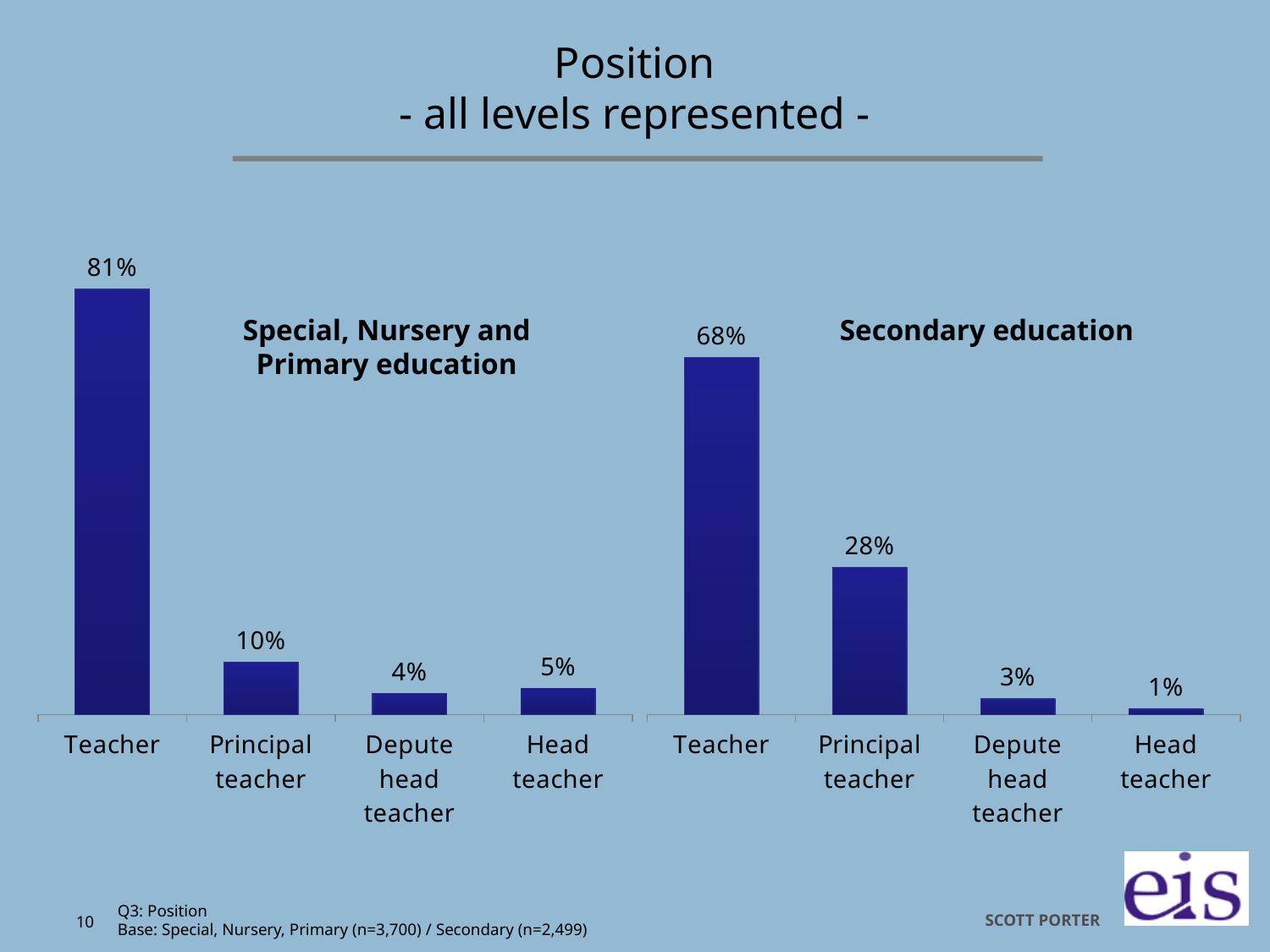
In the Special, Nursery and Primary education chart, what is the value for Depute head teacher? 4% In the Special, Nursery and Primary education chart, which position has the lowest value? Depute head teacher In the Special, Nursery and Primary education chart, what is the difference between the values for Principal teacher and Head teacher? 5% In the Secondary education chart, what is the difference between the values for Teacher and Principal teacher? 40% Which is larger: the Teacher value in the Special, Nursery and Primary education chart or the Teacher value in the Secondary education chart? Special, Nursery and Primary education How many positions are shown in the Secondary education chart? 4 In the Secondary education chart, which position has the highest value? Teacher In the Secondary education chart, what is the value for Principal teacher? 28% What is the title of the slide? Position - all levels represented - In the Special, Nursery and Primary education chart, what is the value for Teacher? 81% What type of chart is the Special, Nursery and Primary education chart? Bar chart In the Secondary education chart, what is the value for Head teacher? 1%